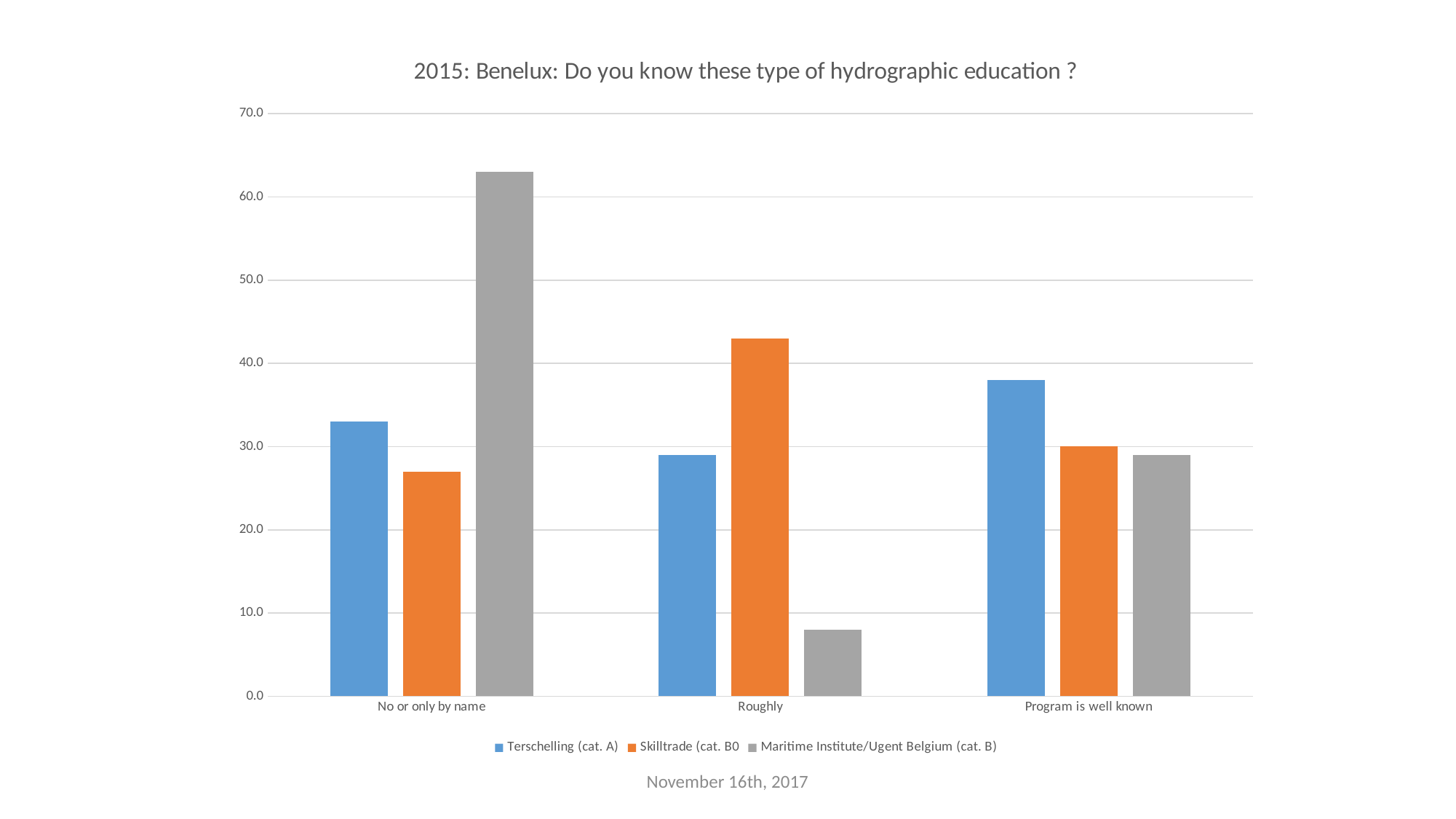
What is the title of the chart? 2015: Benelux: Do you know these type of hydrographic education ? In the 'Roughly' category, which is larger: Terschelling (cat. A) or Skilltrade? Skilltrade Which series has the highest bar in the 'Program is well known' category? Terschelling (cat. A) Which series has the highest bar in the 'No or only by name' category? Maritime Institute/Ugent Belgium (cat. B) Is the value for Maritime Institute/Ugent Belgium (cat. B) in the 'Roughly' category greater or less than 10? less How many categories are shown on the x axis? 3 Is the value for Skilltrade in the 'Roughly' category greater or less than 40? greater Which series has the lowest bar in the 'Roughly' category? Maritime Institute/Ugent Belgium (cat. B) Is the value for Maritime Institute/Ugent Belgium (cat. B) in the 'No or only by name' category greater or less than 60? greater What kind of chart is shown on the slide? bar chart How many series does the legend list? 3